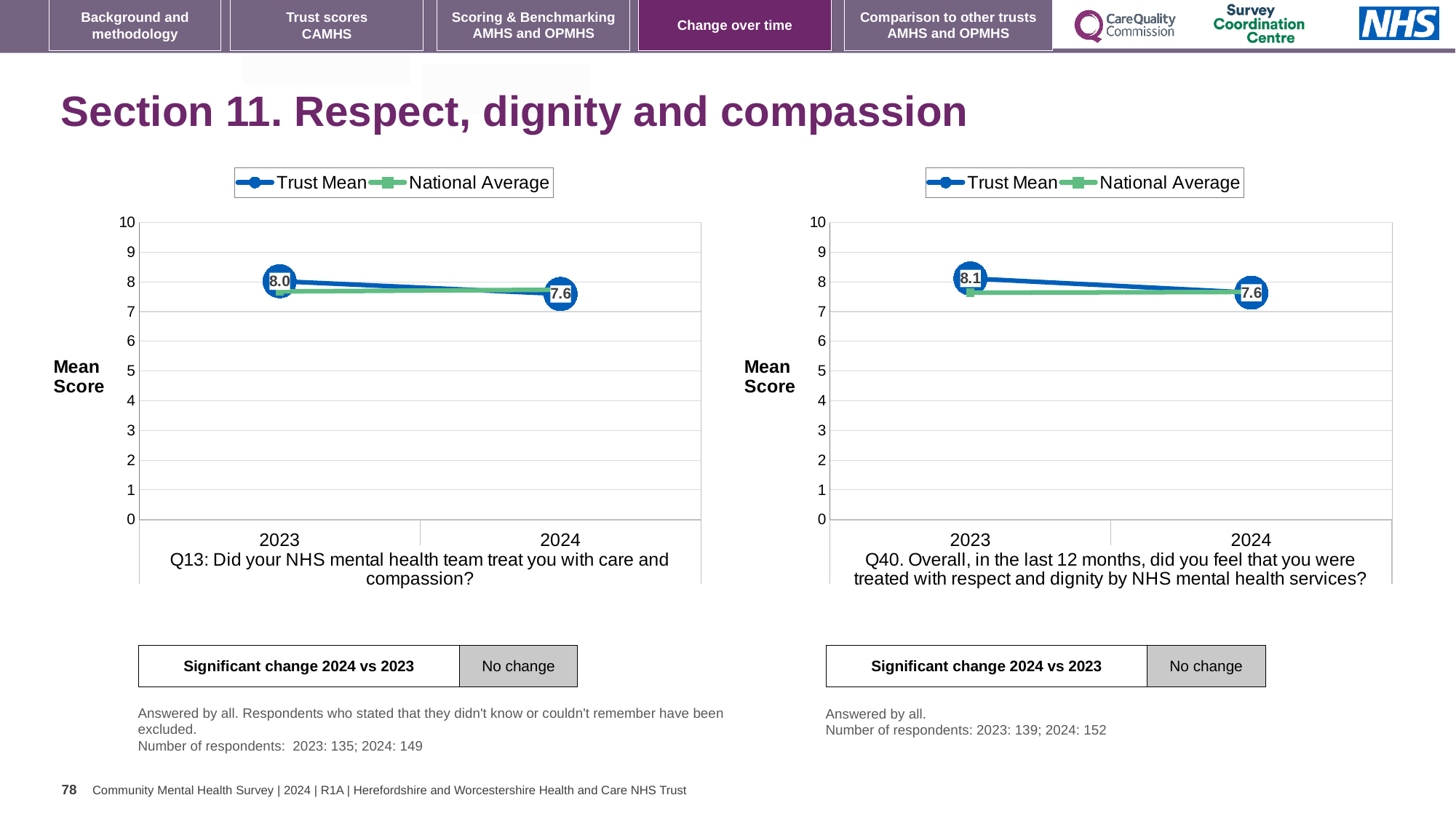
What kind of chart is the left chart (Q13)? line chart In the right chart (Q40), what is the difference between the Trust Mean in 2023 and in 2024? 0.5 In the right chart (Q40), what is the Trust Mean score for 2023? 8.1 In the left chart (Q13), by how much did the Trust Mean change from 2023 to 2024? 0.4 How many series does the legend of the right chart (Q40) list? 2 In the right chart (Q40), is the National Average value for 2024 greater or less than 5? greater In the right chart (Q40), does the Trust Mean rise or fall from 2023 to 2024? fall In the left chart (Q13), which year has the higher Trust Mean, 2023 or 2024? 2023 In the left chart (Q13), what is the Trust Mean score for 2024? 7.6 How many years are plotted on the x axis of the left chart (Q13)? 2 In the right chart (Q40), what is the Trust Mean score for 2024? 7.6 In the left chart (Q13), what is the Trust Mean score for 2023? 8.0